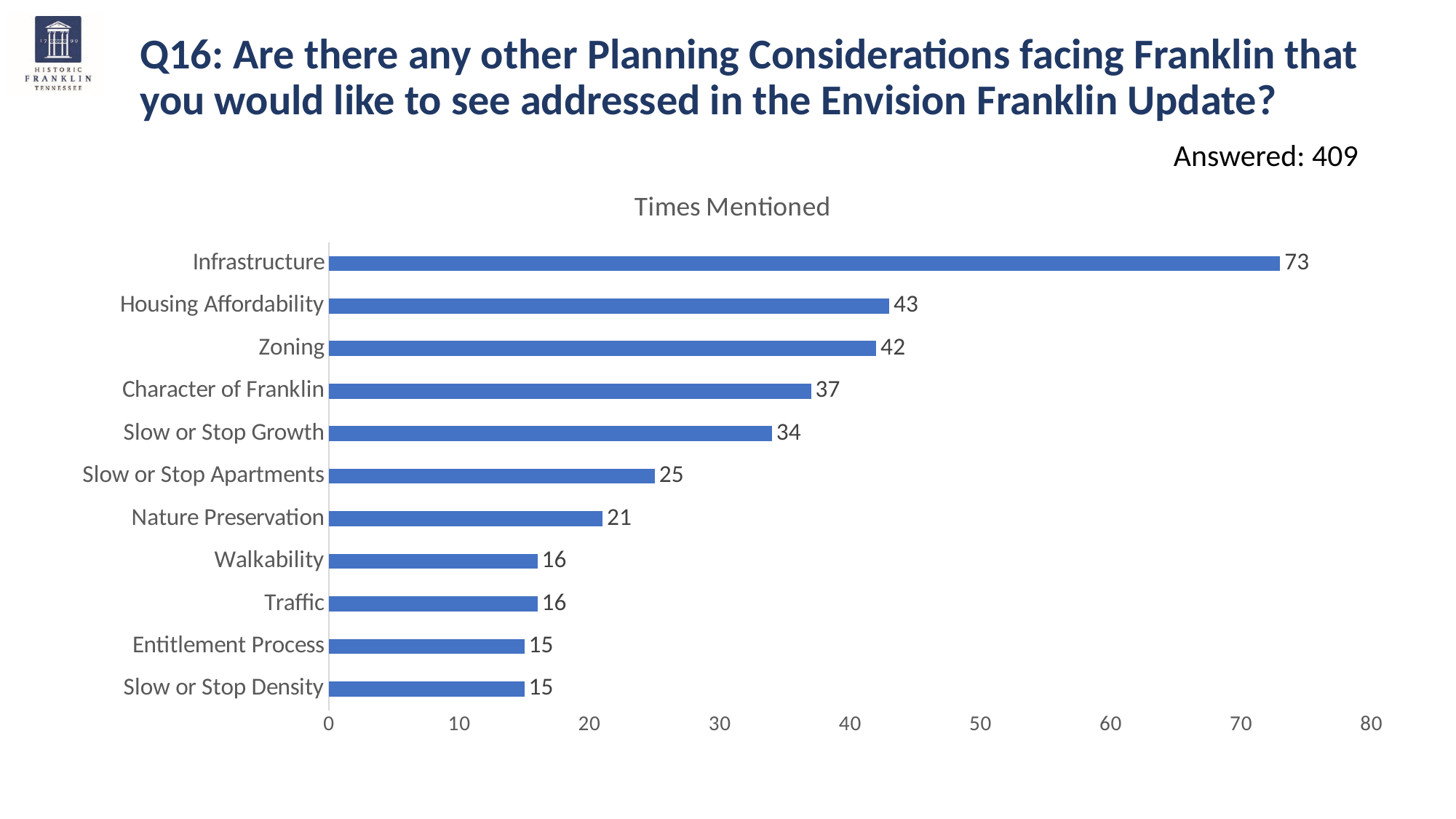
What is the value for Slow or Stop Apartments? 25 Which category was mentioned the most times? Infrastructure What is the value for Nature Preservation? 21 How many categories are shown in the chart? 11 What is the title of the chart? Times Mentioned How many respondents answered the question, according to the slide? 409 What is the difference between Character of Franklin and Slow or Stop Growth? 3 What is the difference between Infrastructure and Housing Affordability? 30 How many times was Infrastructure mentioned? 73 What kind of chart is shown on the slide? Bar chart Which is larger, Zoning or Character of Franklin? Zoning Is the value for Slow or Stop Growth greater or less than 30? greater